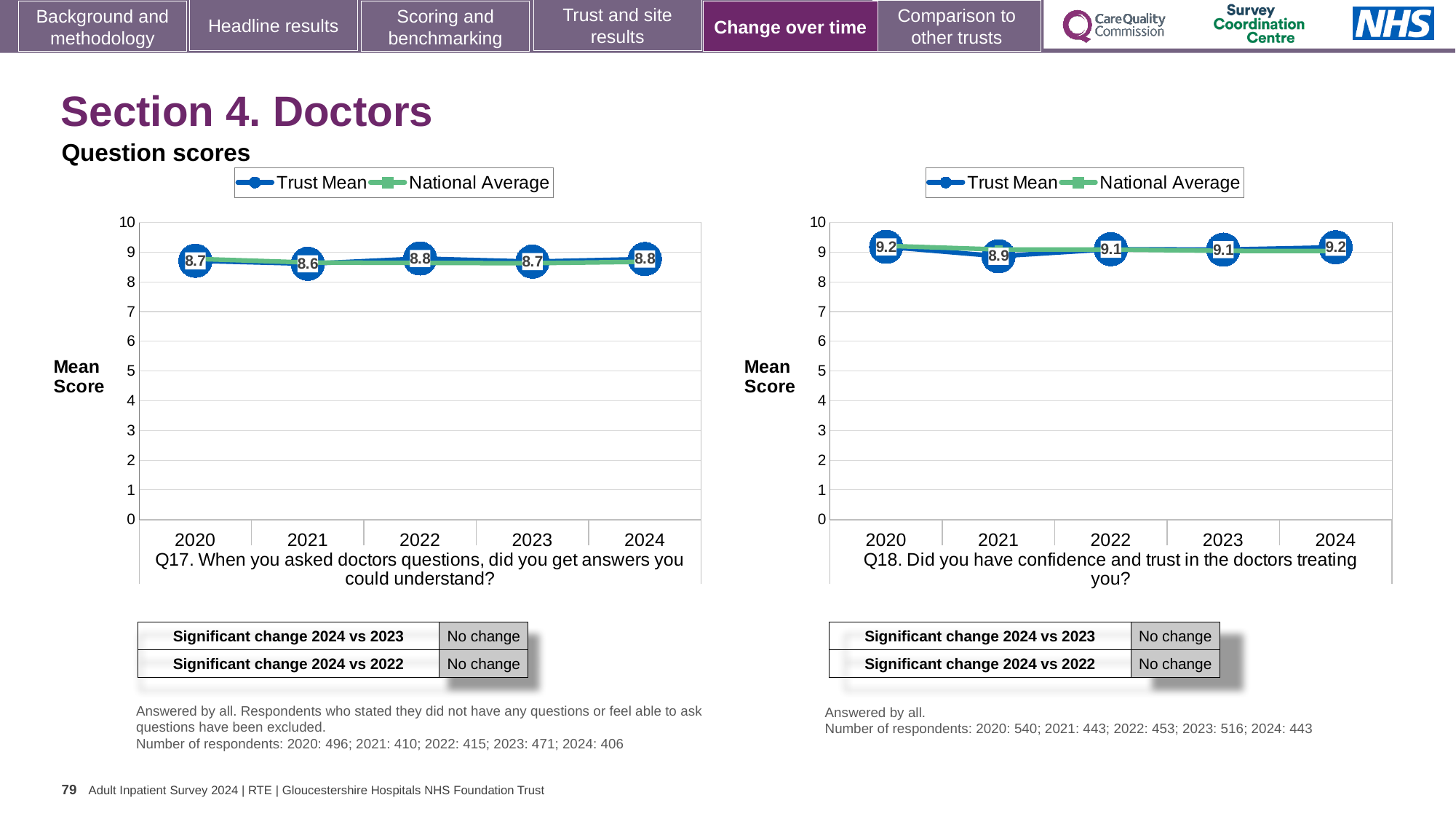
In the Q17 chart on the left, what is the Trust Mean score for 2022? 8.8 How many years are plotted on the x axis of the Q17 chart on the left? 5 In the Q17 chart on the left, what is the difference between the Trust Mean scores for 2022 and 2021? 0.2 In the Q17 chart on the left, is the Trust Mean score higher in 2021 or in 2022? 2022 In the Q18 chart on the right, which year has the lowest Trust Mean score? 2021 How many series does the legend of the Q18 chart on the right list? 2 In the Q18 chart on the right, what is the Trust Mean score for 2021? 8.9 In the Q17 chart on the left, what is the Trust Mean score for 2021? 8.6 In the Q17 chart on the left, which year has the lowest Trust Mean score? 2021 In the Q18 chart on the right, what is the difference between the Trust Mean scores for 2024 and 2021? 0.3 In the Q18 chart on the right, is the National Average value for 2020 greater or less than 8? greater In the Q18 chart on the right, what is the Trust Mean score for 2020? 9.2